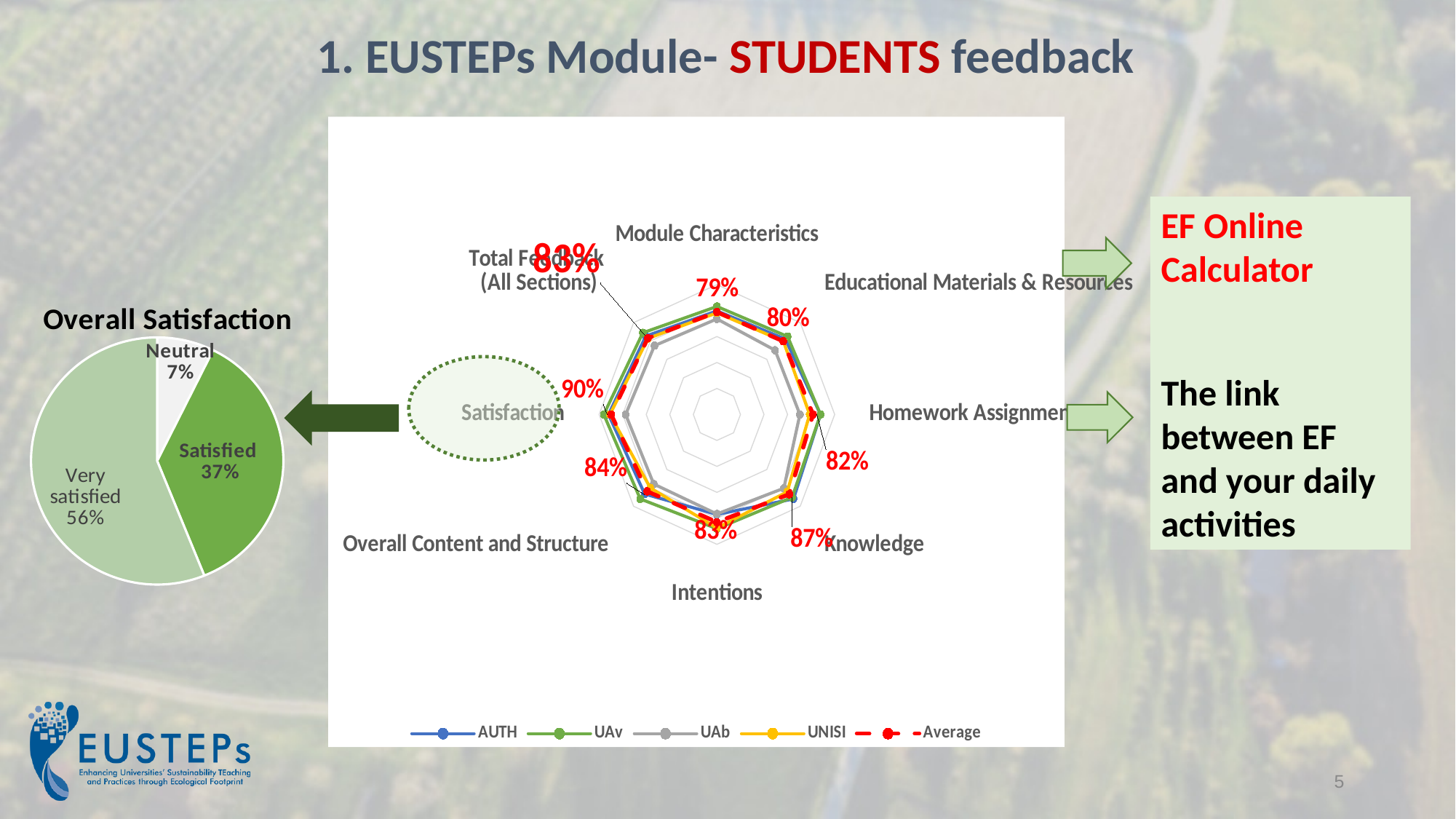
In the Overall Satisfaction pie chart, which category has the largest slice? Very satisfied In the radar chart, what is the Average value labelled for Knowledge? 87% What type of chart is the large chart in the centre of the slide? Radar chart In the radar chart, which category has the lowest labelled Average value? Module Characteristics In the Overall Satisfaction pie chart, what share of respondents were Very satisfied? 56% In the Overall Satisfaction pie chart, which category has the smallest slice? Neutral In the radar chart, what is the Average value labelled for Satisfaction? 90% In the radar chart, is the labelled Average value larger for Homework Assignment or for Intentions? Intentions In the Overall Satisfaction pie chart, what percentage were Neutral? 7% In the Overall Satisfaction pie chart, what is the difference in percentage points between Very satisfied and Satisfied? 19 How many slices does the Overall Satisfaction pie chart have? 3 How many series does the legend of the radar chart list? 5